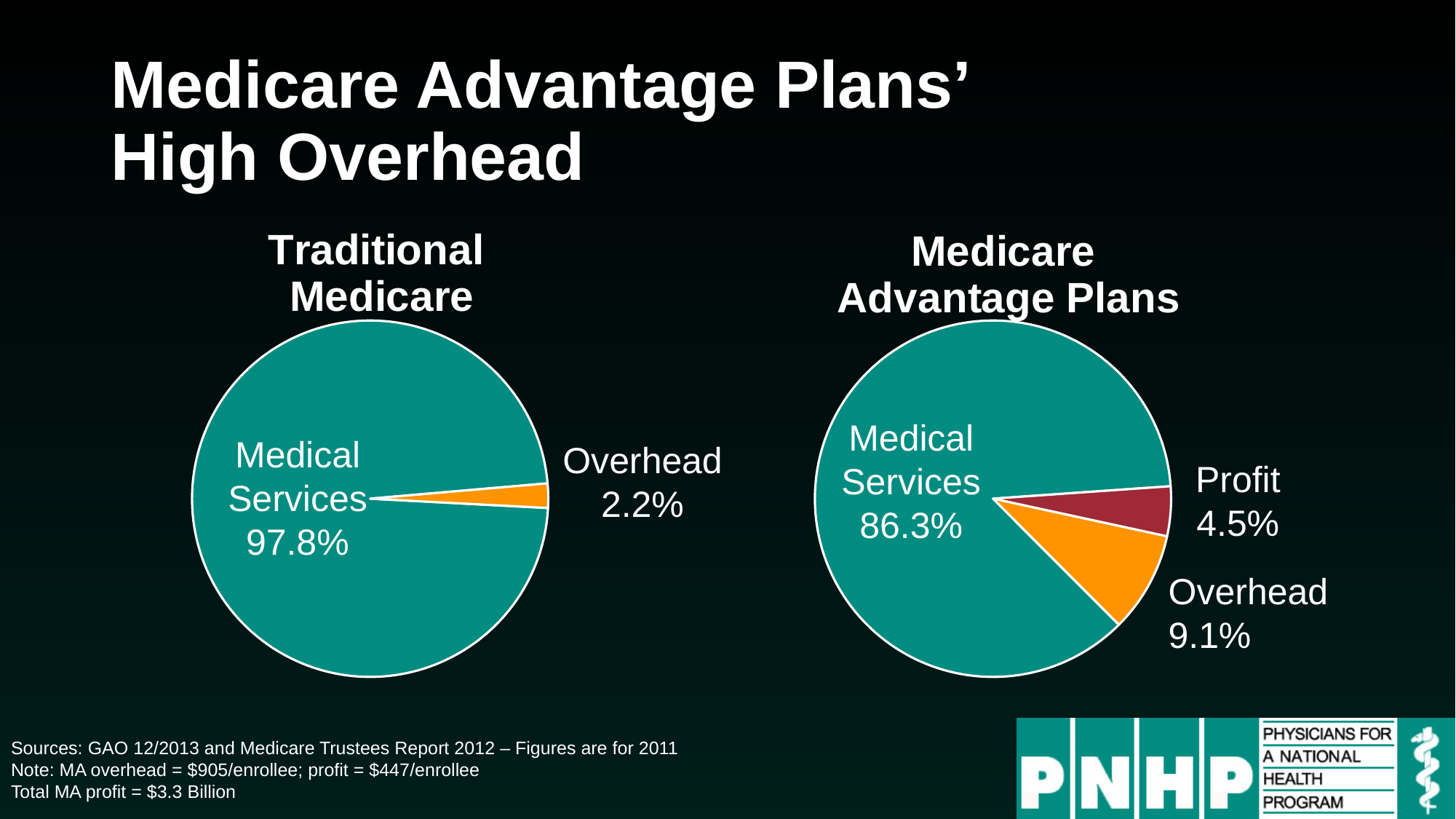
In the Medicare Advantage Plans chart, which slice is the smallest? Profit In the Medicare Advantage Plans chart, what share goes to Overhead? 9.1% Which chart has the larger Overhead share, Traditional Medicare or Medicare Advantage Plans? Medicare Advantage Plans In the Medicare Advantage Plans chart, what share goes to Medical Services? 86.3% What type of chart is used for the Traditional Medicare chart? Pie chart In the Medicare Advantage Plans chart, how many slices does the pie have? 3 What is the difference between the Overhead share in the Medicare Advantage Plans chart and the Overhead share in the Traditional Medicare chart? 6.9% In the Medicare Advantage Plans chart, which slice is the largest? Medical Services In the Traditional Medicare chart, what share goes to Medical Services? 97.8% In the Traditional Medicare chart, how many slices does the pie have? 2 In the Traditional Medicare chart, what share goes to Overhead? 2.2% In the Medicare Advantage Plans chart, what share goes to Profit? 4.5%